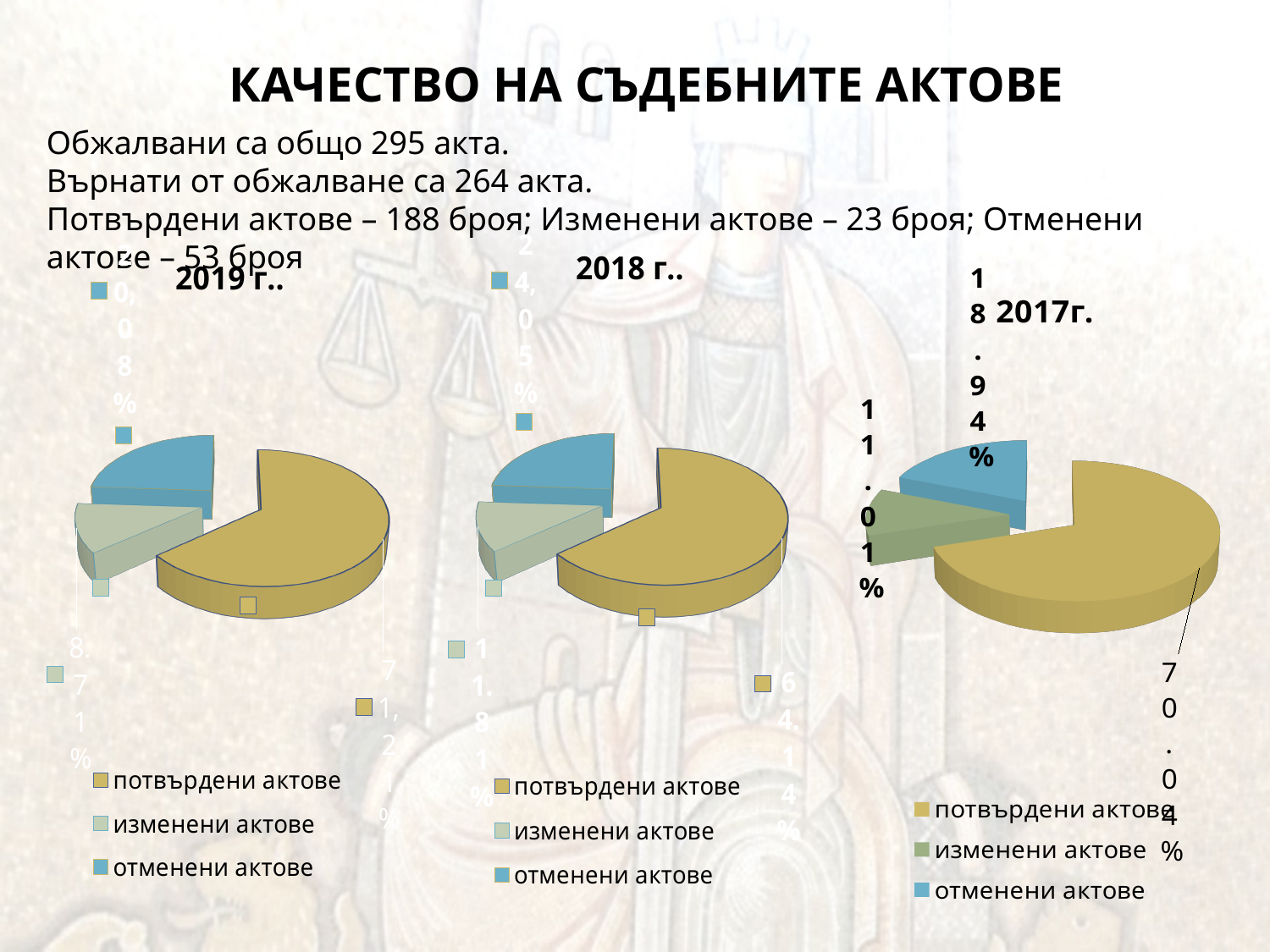
How many entries does the legend of the 2019 г. chart list? 3 In the 2017г. chart, which category has the smallest slice? изменени актове In the 2018 г. chart, what is the share for отменени актове? 24,05% In the 2018 г. chart, which is larger: изменени актове or отменени актове? отменени актове In the 2017г. chart, what is the share for изменени актове? 11.01% What kind of chart is the 2017г. chart? pie chart In the 2018 г. chart, which category has the largest slice? потвърдени актове In the 2018 г. chart, what is the difference between the shares of потвърдени актове and отменени актове? 40.09% In the 2017г. chart, what is the share for отменени актове? 18.94% In the 2018 г. chart, what is the share for потвърдени актове? 64.14% In the 2019 г. chart, what is the share for изменени актове? 8.71% In the 2019 г. chart, what is the share for потвърдени актове? 71,21%